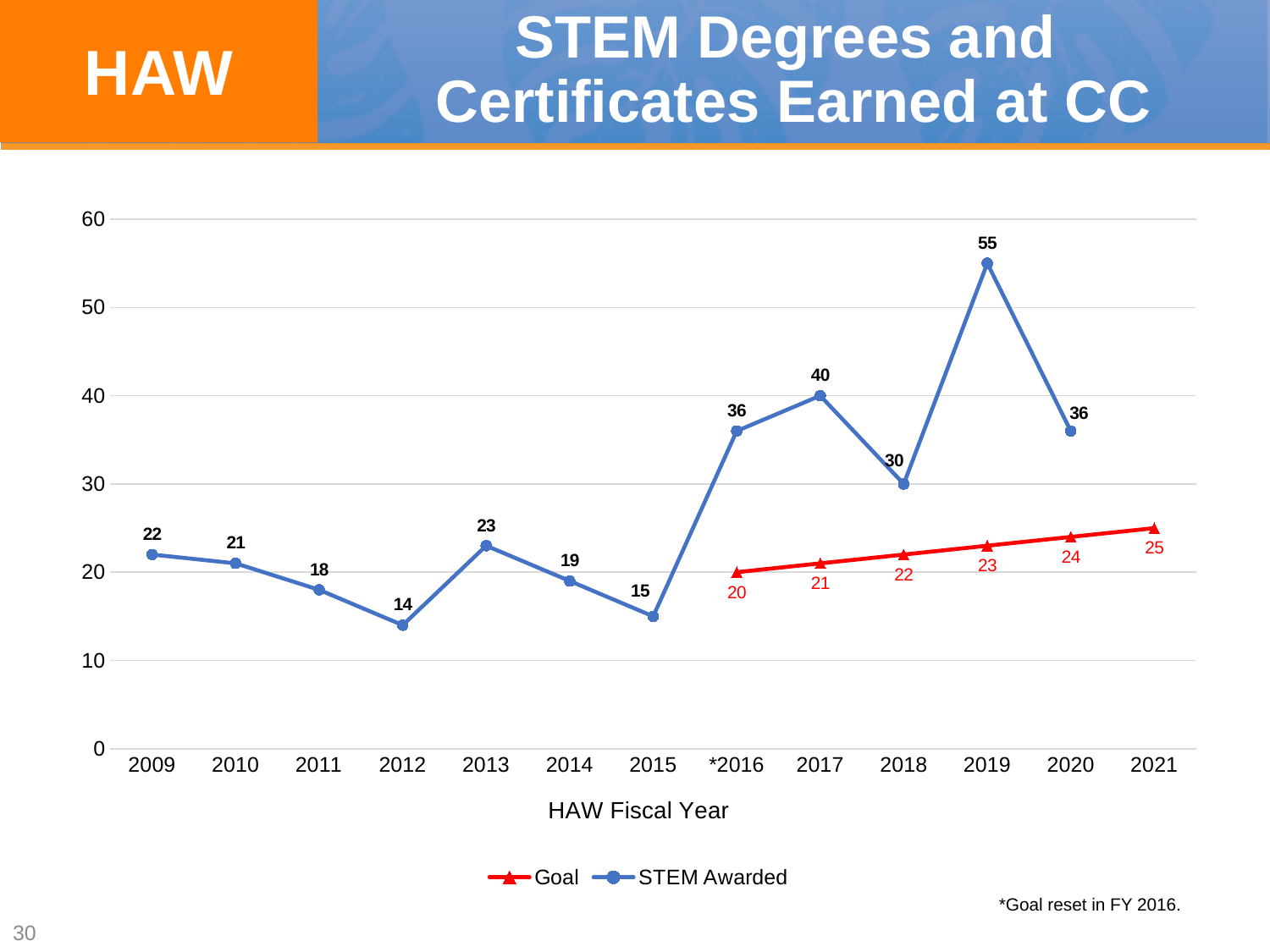
Is the STEM Awarded value for 2017 greater or less than 30? greater Which is larger in 2018, the STEM Awarded value or the Goal value? STEM Awarded In which year was the STEM Awarded value highest? 2019 What is the difference between the STEM Awarded value and the Goal value in 2019? 32 How many fiscal years are shown on the x axis? 13 How many series does the legend list? 2 What was the STEM Awarded value in 2012? 14 What is the Goal value for 2021? 25 In which year was the STEM Awarded value lowest? 2012 What kind of chart is shown on the slide? Line chart Does the Goal series rise or fall from 2016 to 2021? Rise What was the STEM Awarded value in 2019? 55